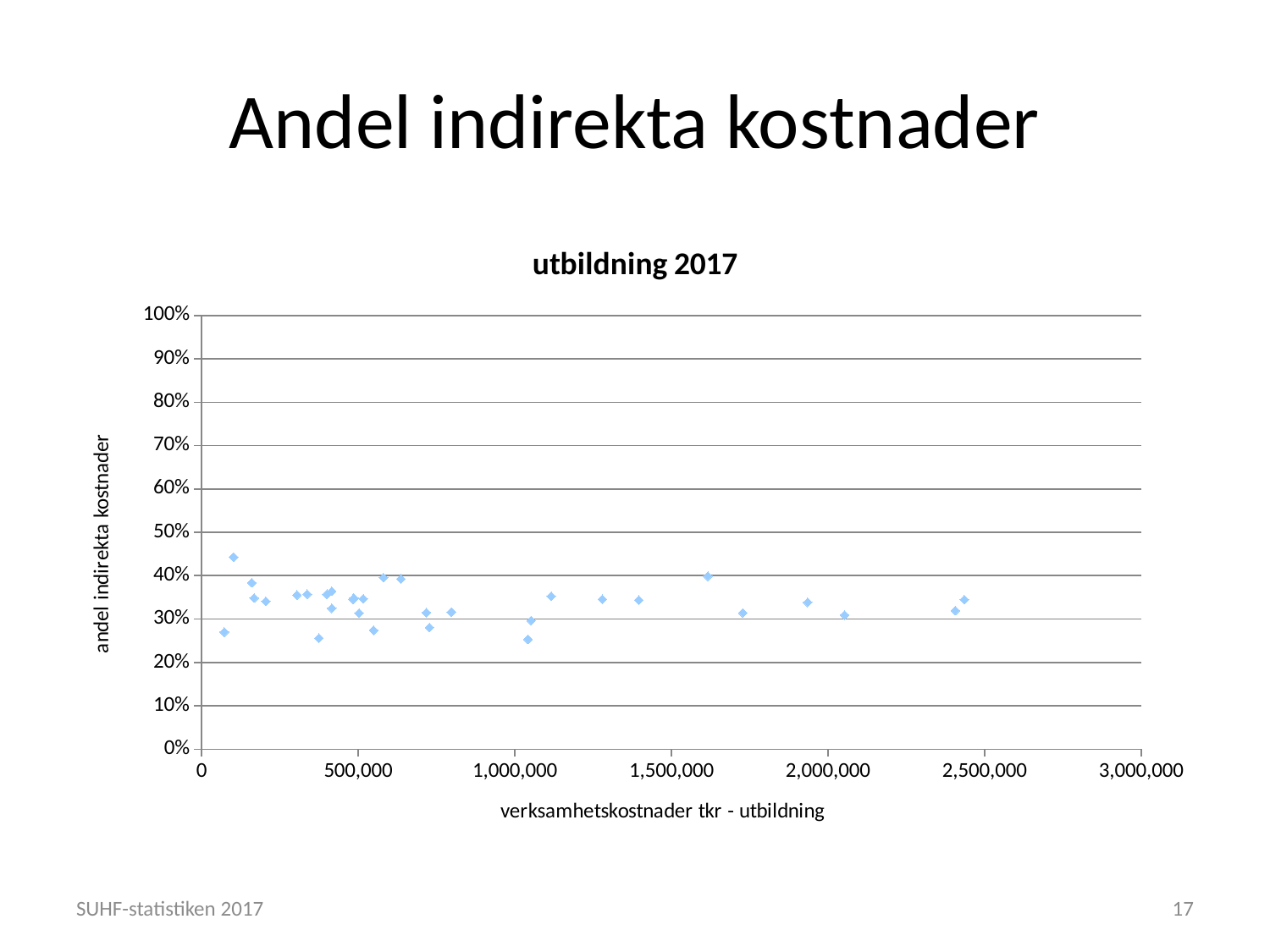
What is the label of the x axis? verksamhetskostnader tkr - utbildning Is the lowest plotted value on the y axis greater or less than 20%? greater Do the plotted values clearly rise, clearly fall, or stay roughly flat as the x value increases? roughly flat What is the highest value shown on the y axis? 100% Is the value for the point with the smallest x value greater or less than 30%? less Is the highest plotted value on the y axis greater or less than 50%? less What is the title of the chart? utbildning 2017 What kind of chart is shown on the slide? scatter chart